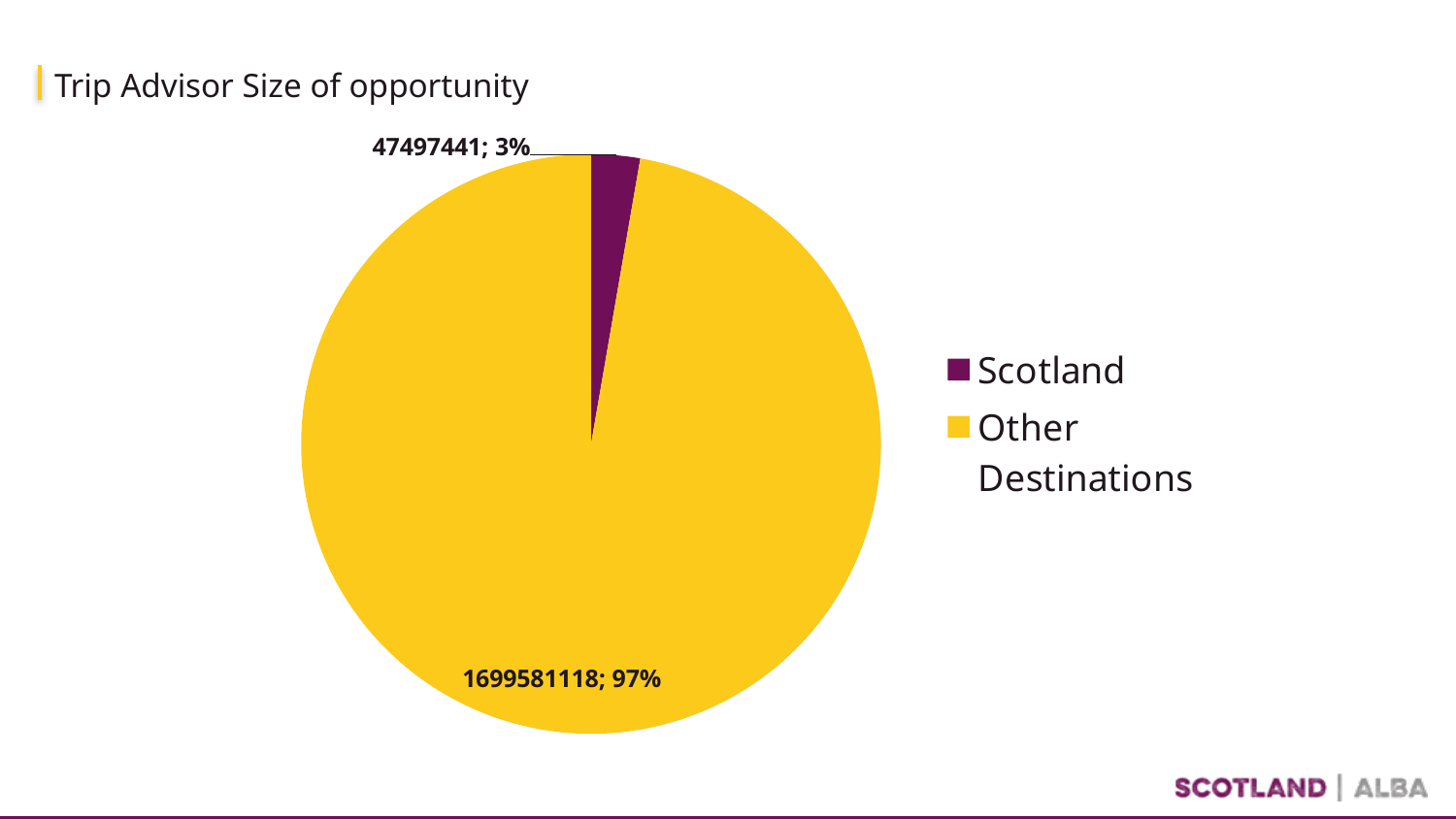
What is the title of the chart? Trip Advisor Size of opportunity Which slice is the smallest? Scotland What share of the pie does Other Destinations represent? 97% What share of the pie does Scotland represent? 3% How many slices does the pie chart have? 2 What is the value for Other Destinations? 1699581118 Which slice is the largest? Other Destinations What colour is the Scotland slice? purple Which is larger, Scotland or Other Destinations? Other Destinations What is the difference between the values for Other Destinations and Scotland? 1652083677 What kind of chart is shown on the slide? pie chart What is the value for Scotland? 47497441